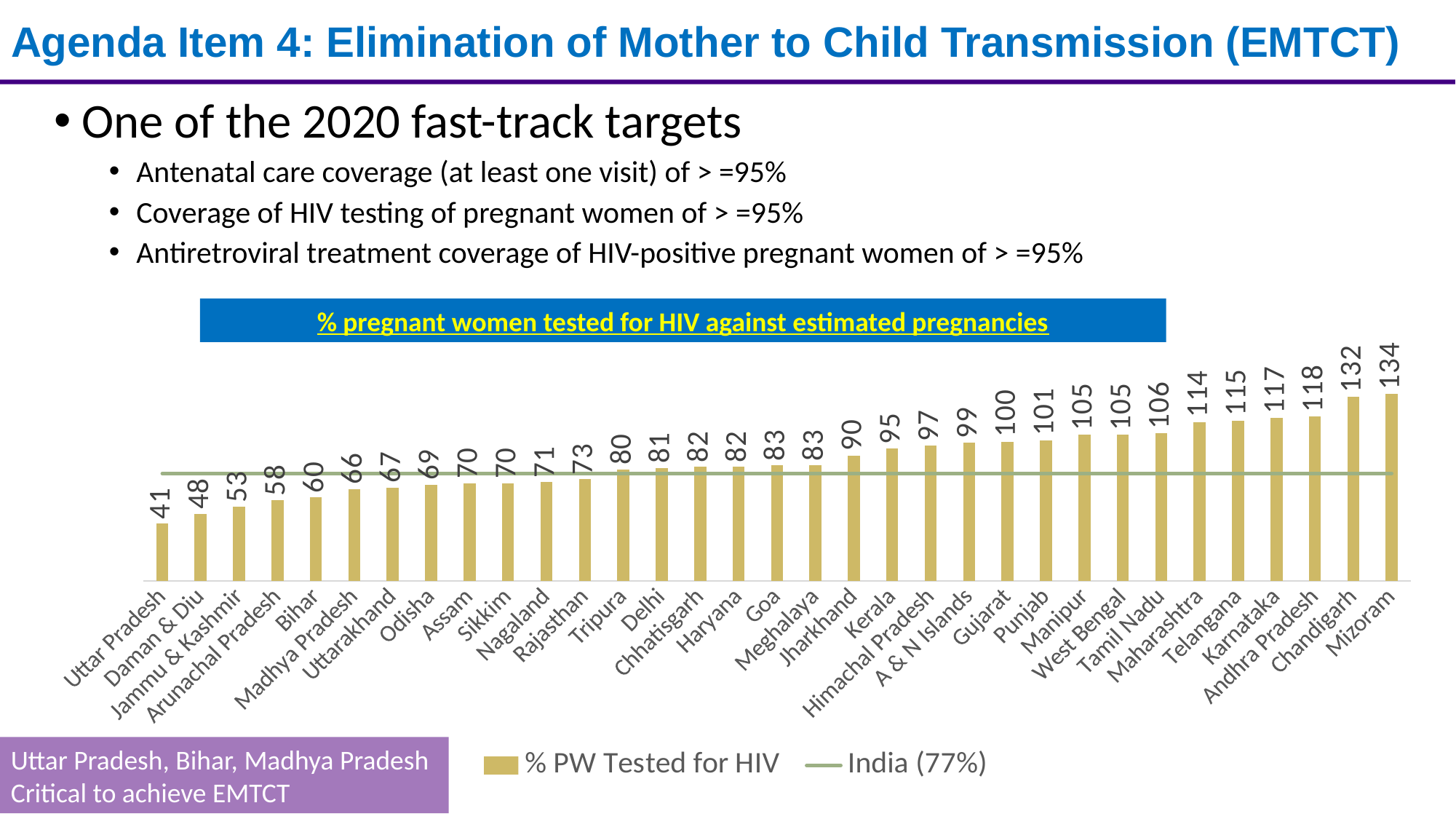
What is the India value shown in the chart legend? 77% What is the value for Bihar in the chart? 60 What is the difference between the values for Mizoram and Chandigarh? 2 How many states and territories are shown in the chart? 33 Which has a larger value, Gujarat or Rajasthan? Gujarat What kind of chart is shown on the slide? Bar chart What is the value for Kerala in the chart? 95 What is the value for Uttar Pradesh in the chart? 41 Which state or territory has the lowest value in the chart? Uttar Pradesh How many series does the chart legend list? 2 Which state or territory has the highest value in the chart? Mizoram What is the difference between the values for Tamil Nadu and Uttar Pradesh? 65